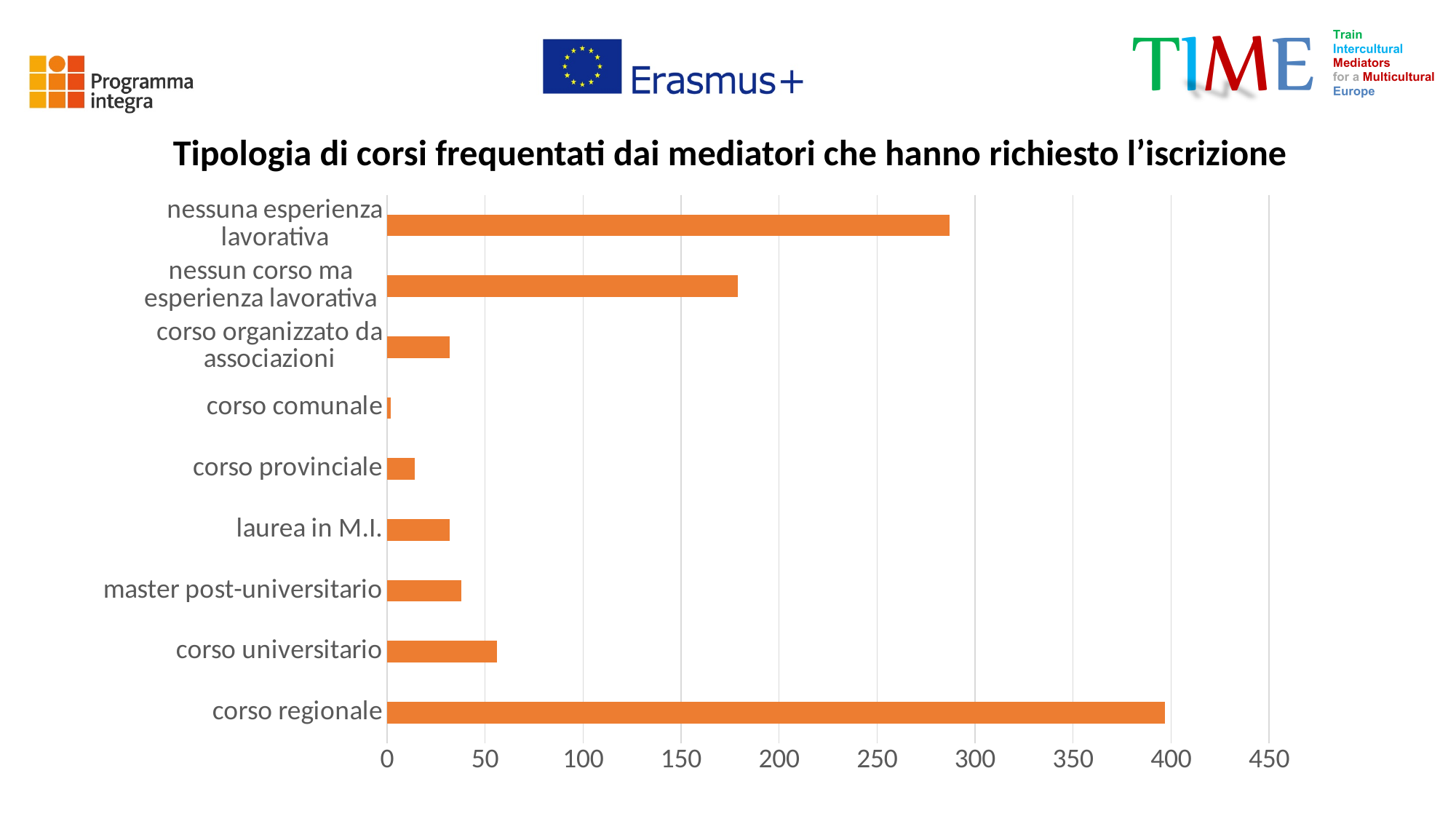
Is the value for master post-universitario greater or less than 50? less Is the value for nessuna esperienza lavorativa greater or less than 300? less Is the value for corso regionale greater or less than 350? greater How many categories are plotted in the chart? 9 Which is larger, the value for corso universitario or the value for master post-universitario? corso universitario Which category has the lowest value? corso comunale What is the title of the chart? Tipologia di corsi frequentati dai mediatori che hanno richiesto l'iscrizione Which category has the highest value? corso regionale Which is larger, the value for nessuna esperienza lavorativa or the value for nessun corso ma esperienza lavorativa? nessuna esperienza lavorativa What kind of chart is shown on the slide? bar chart Which is larger, the value for corso provinciale or the value for corso comunale? corso provinciale